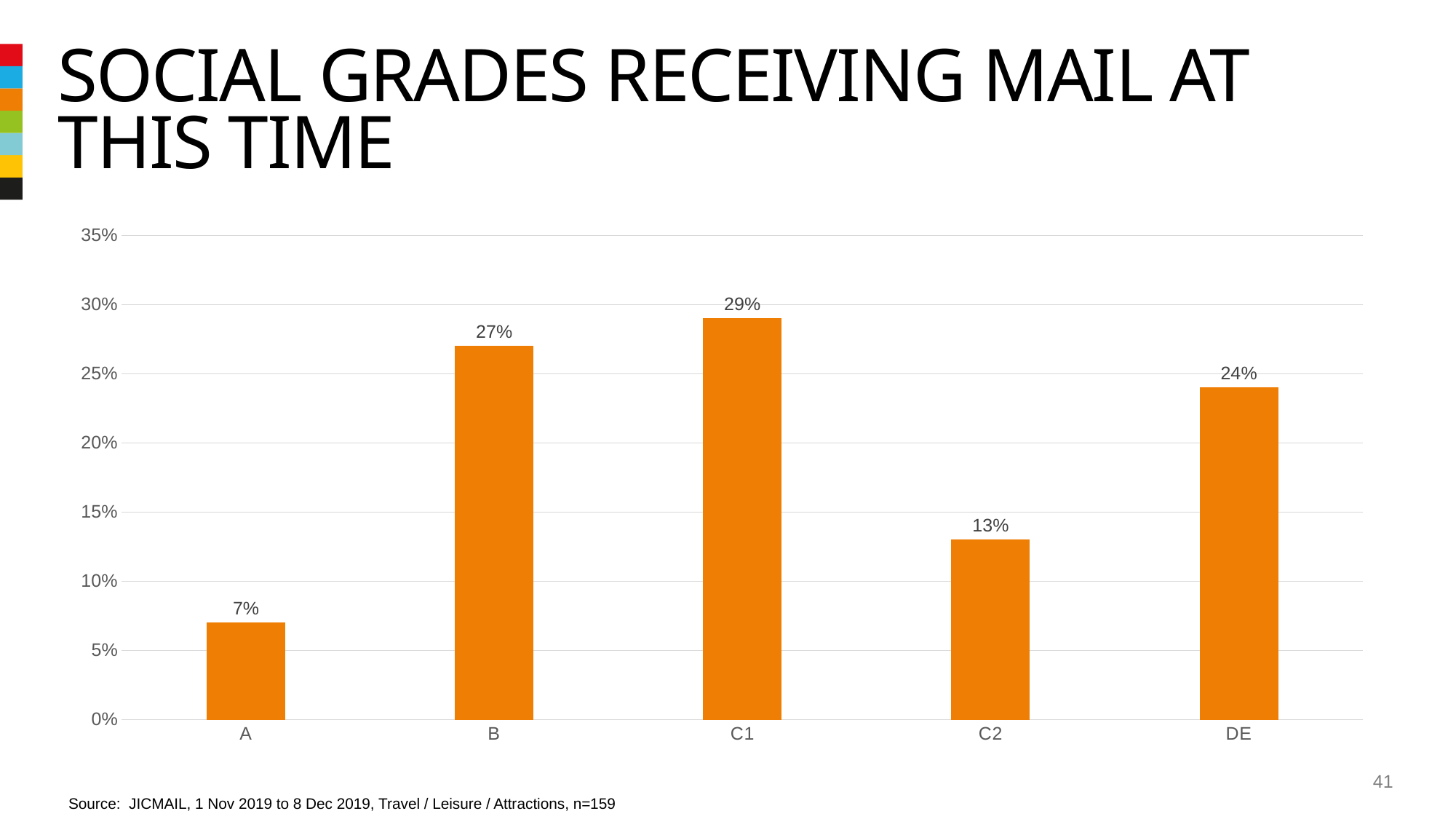
What is the difference between the values for B and C2? 14% What kind of chart is shown on the slide? Bar chart What is the title of the chart on the slide? Social grades receiving mail at this time What colour are the bars in the chart? Orange What is the value for social grade C1? 29% How many social grades are shown on the x axis? 5 Which has a larger value, DE or C2? DE Is the value for B greater or less than 25%? greater What is the value for social grade A? 7% What is the value for social grade DE? 24% Which social grade has the highest value? C1 Which social grade has the lowest value? A